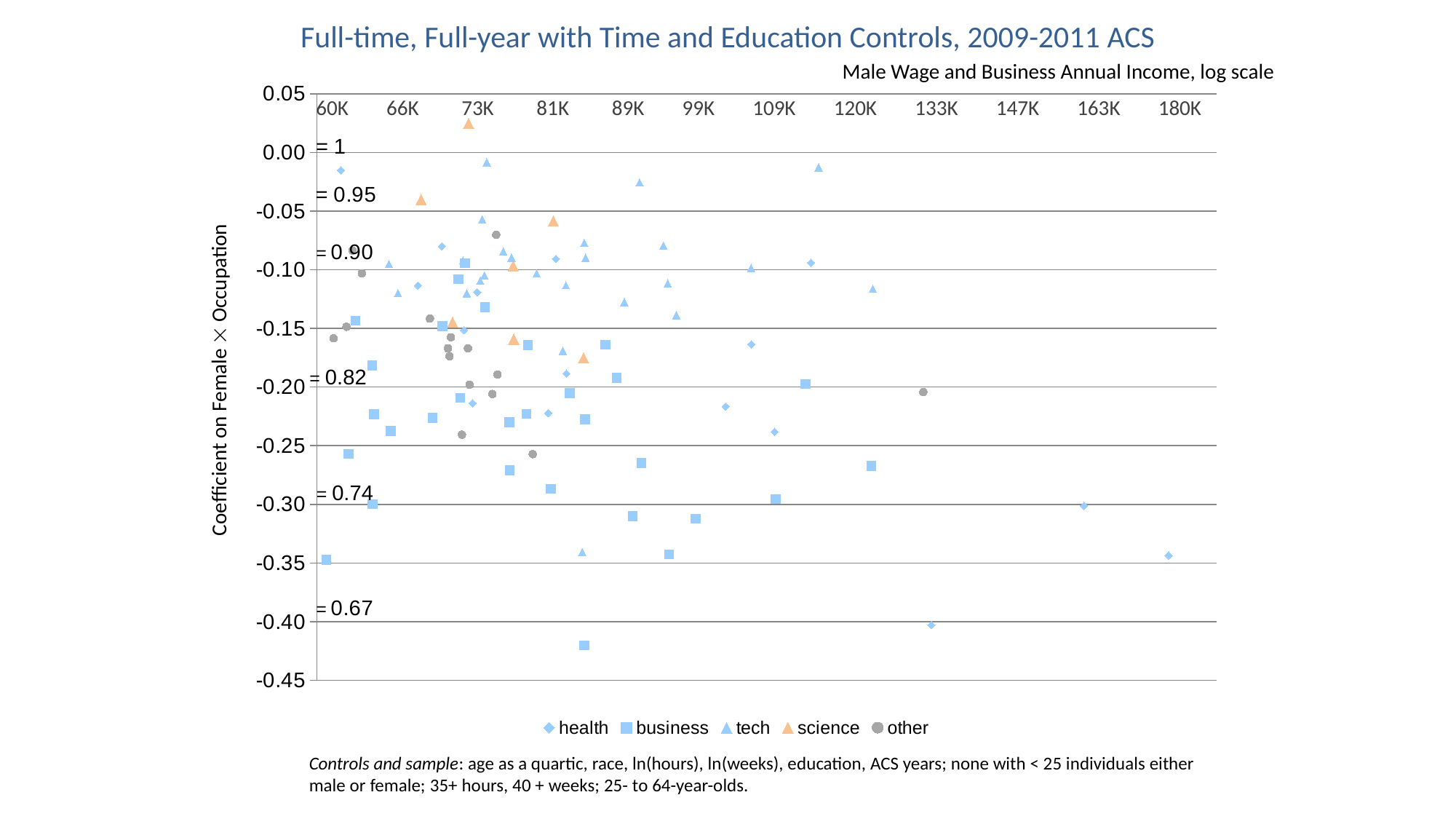
What kind of chart is shown on the slide? scatter chart Which series contains the lowest point on the chart? business What is the lowest value shown on the y axis? -0.45 How many series does the legend list? 5 What is the title of the chart? Full-time, Full-year with Time and Education Controls, 2009-2011 ACS Which series contains the highest point on the chart? science Is the lowest business point greater or less than -0.40? less Is the health point plotted near 180K greater or less than -0.30? less How many tick labels are shown on the x axis? 12 Which series is plotted with grey circle markers? other Is the highest science point greater or less than 0.00? greater